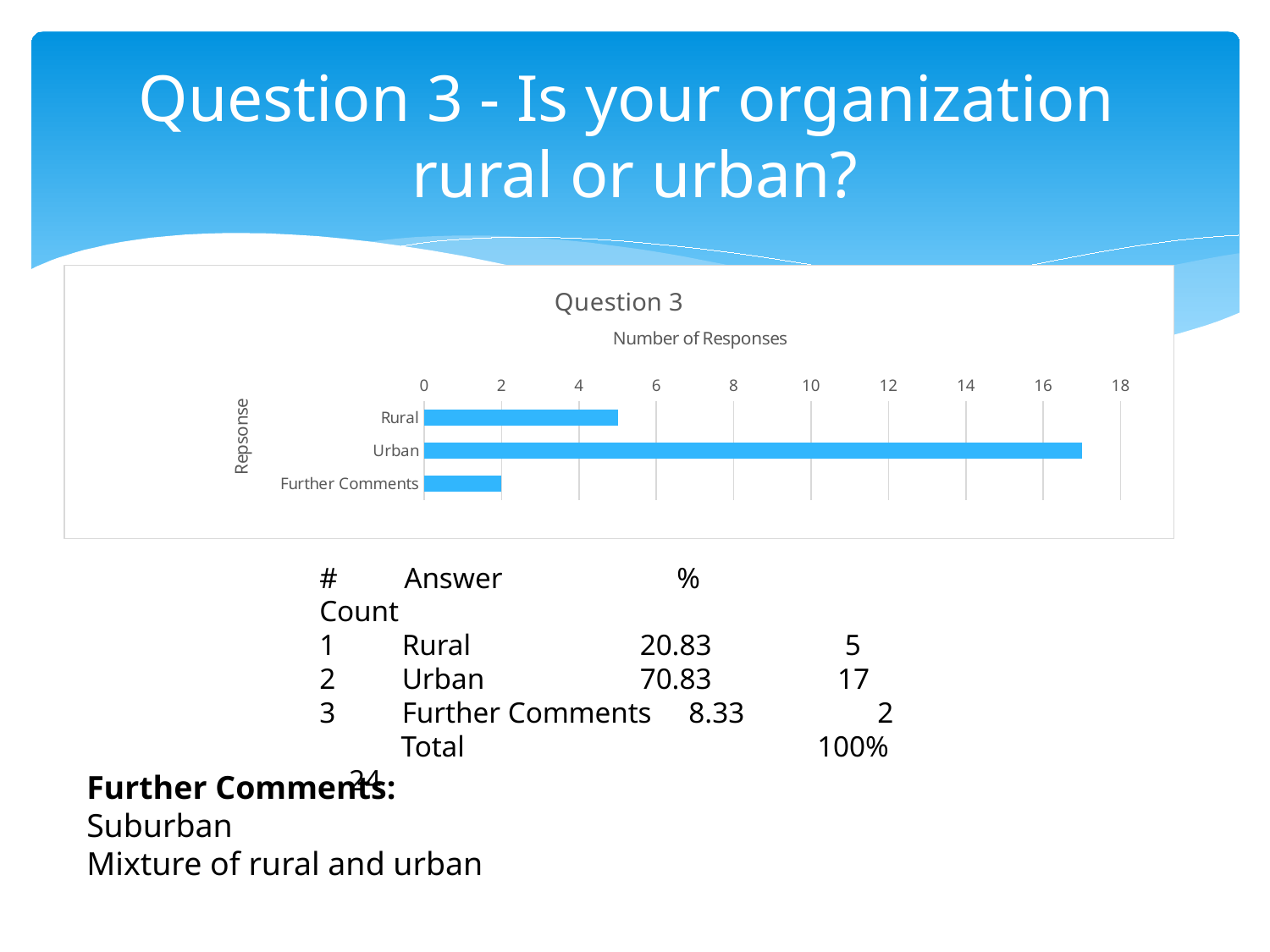
What is the difference between the number of responses for Urban and Rural? 12 What is the number of responses for Rural? 5 What is the number of responses for Urban? 17 Which category has the lowest number of responses? Further Comments Is the value for Urban greater or less than 16? greater Which is larger, the number of responses for Rural or for Further Comments? Rural Which category has the highest number of responses? Urban What kind of chart is shown on the slide? bar chart What is the number of responses for Further Comments? 2 How many categories are plotted in the chart? 3 What is the title of the chart? Question 3 Is the value for Rural greater or less than 6? less